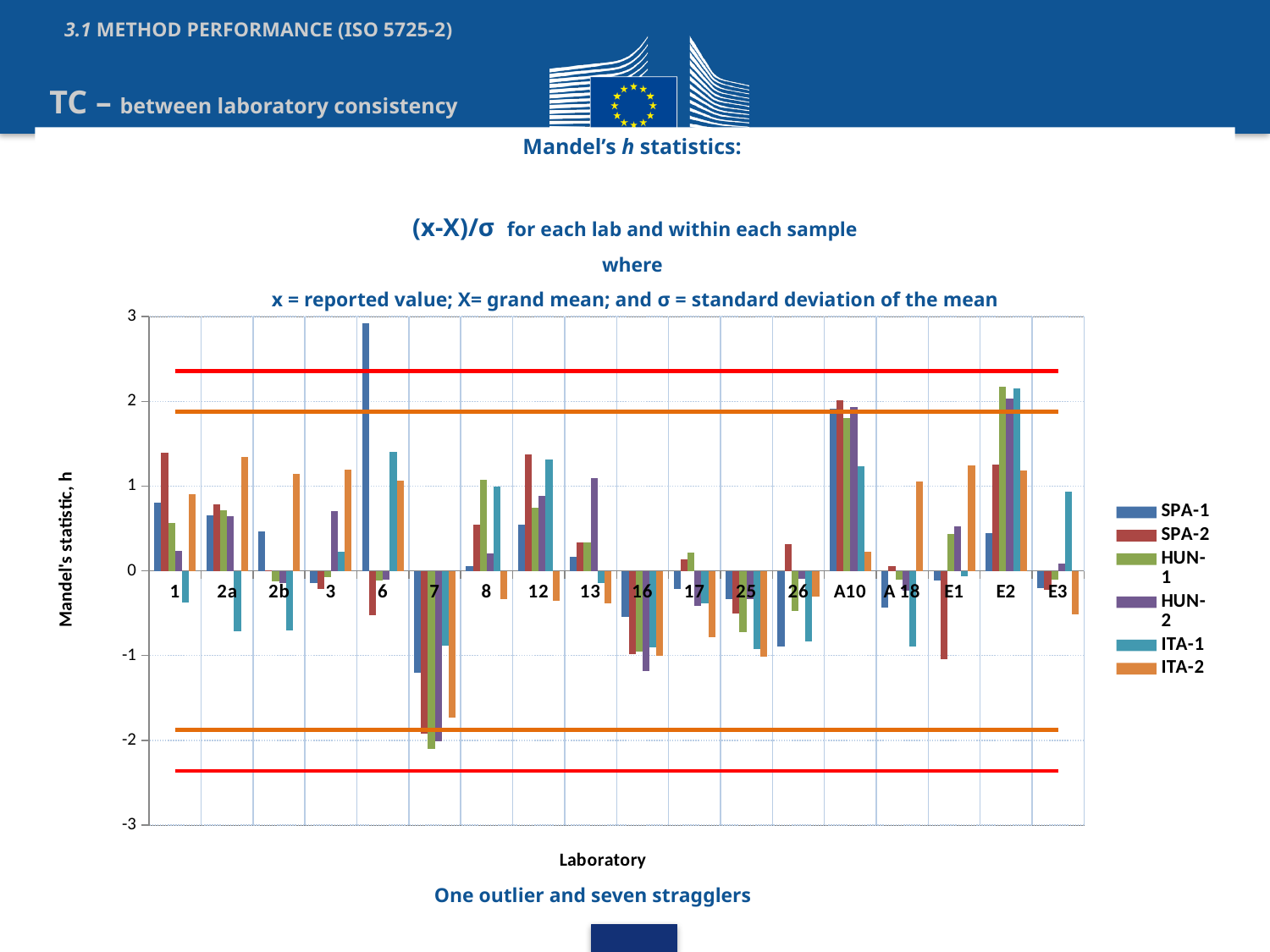
How many laboratories are shown along the x axis of the chart? 18 Which laboratory and series has the lowest Mandel's h statistic in the chart? HUN-1 at laboratory 7 What kind of chart is shown on the slide? bar chart Is the SPA-2 value for laboratory 1 greater or less than 1? greater How many series does the chart legend list? 6 Which laboratory and series has the highest Mandel's h statistic in the chart? SPA-1 at laboratory 6 Is the ITA-2 value for laboratory 7 greater or less than -1? less Is the HUN-1 value for laboratory 7 greater or less than -2? less Which is larger: the SPA-1 value for laboratory 6 or the SPA-2 value for laboratory 1? SPA-1 value for laboratory 6 What is the label of the horizontal axis of the chart? Laboratory What is the label of the vertical axis of the chart? Mandel's statistic, h